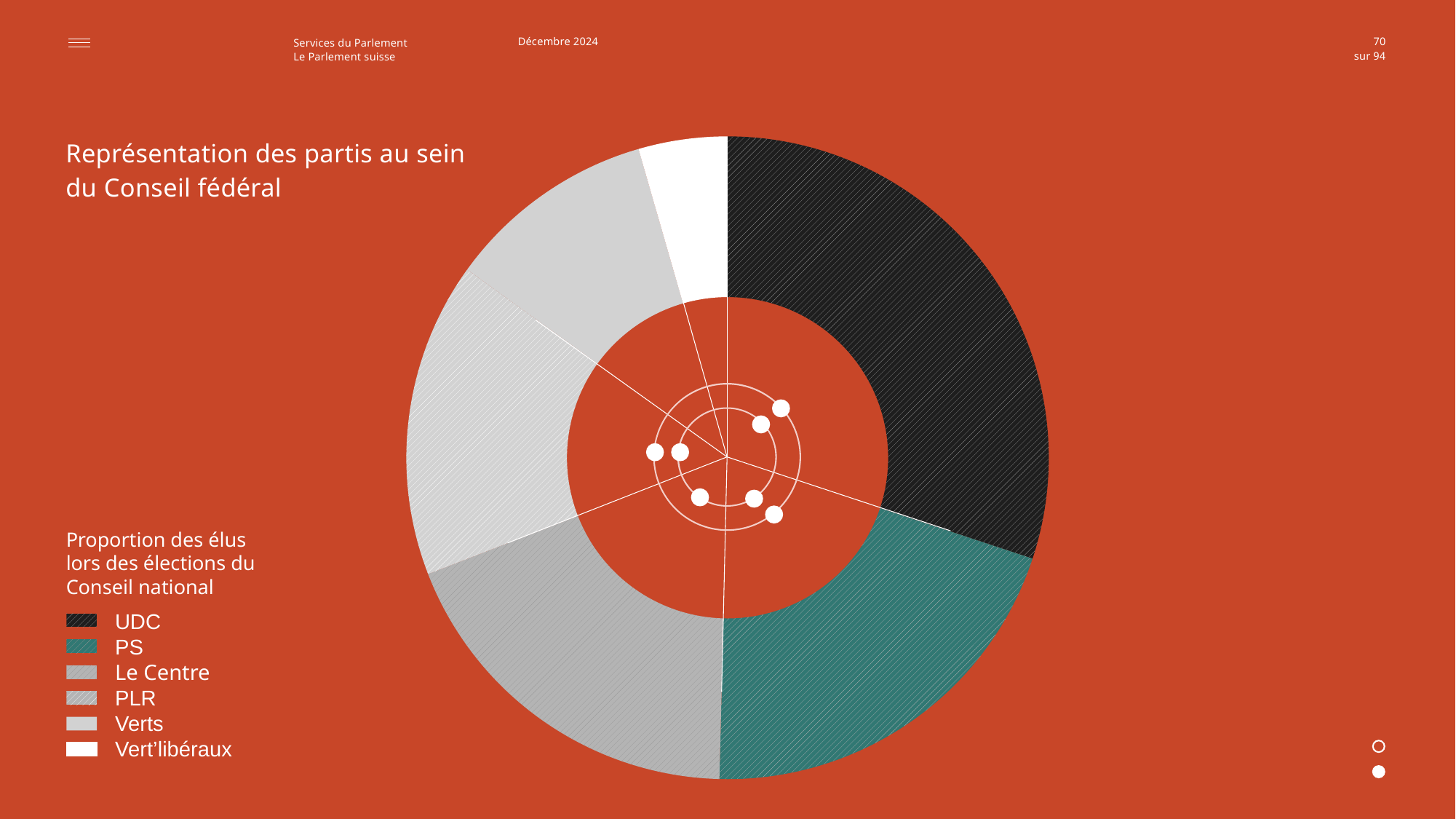
Which slice is larger, UDC or PS? UDC How many white dots are plotted in the centre of the chart? 7 Which party has the largest slice of the chart? UDC Which party is shown in teal/green in the legend? PS How many entries does the legend list? 6 Which slice is larger, Le Centre or Vert'libéraux? Le Centre Which slice is larger, Verts or UDC? UDC Which party has the smallest slice of the chart? Vert'libéraux What is the title of the chart? Représentation des partis au sein du Conseil fédéral What kind of chart is shown on the slide? Doughnut chart How many parties (categories) does the chart show? 6